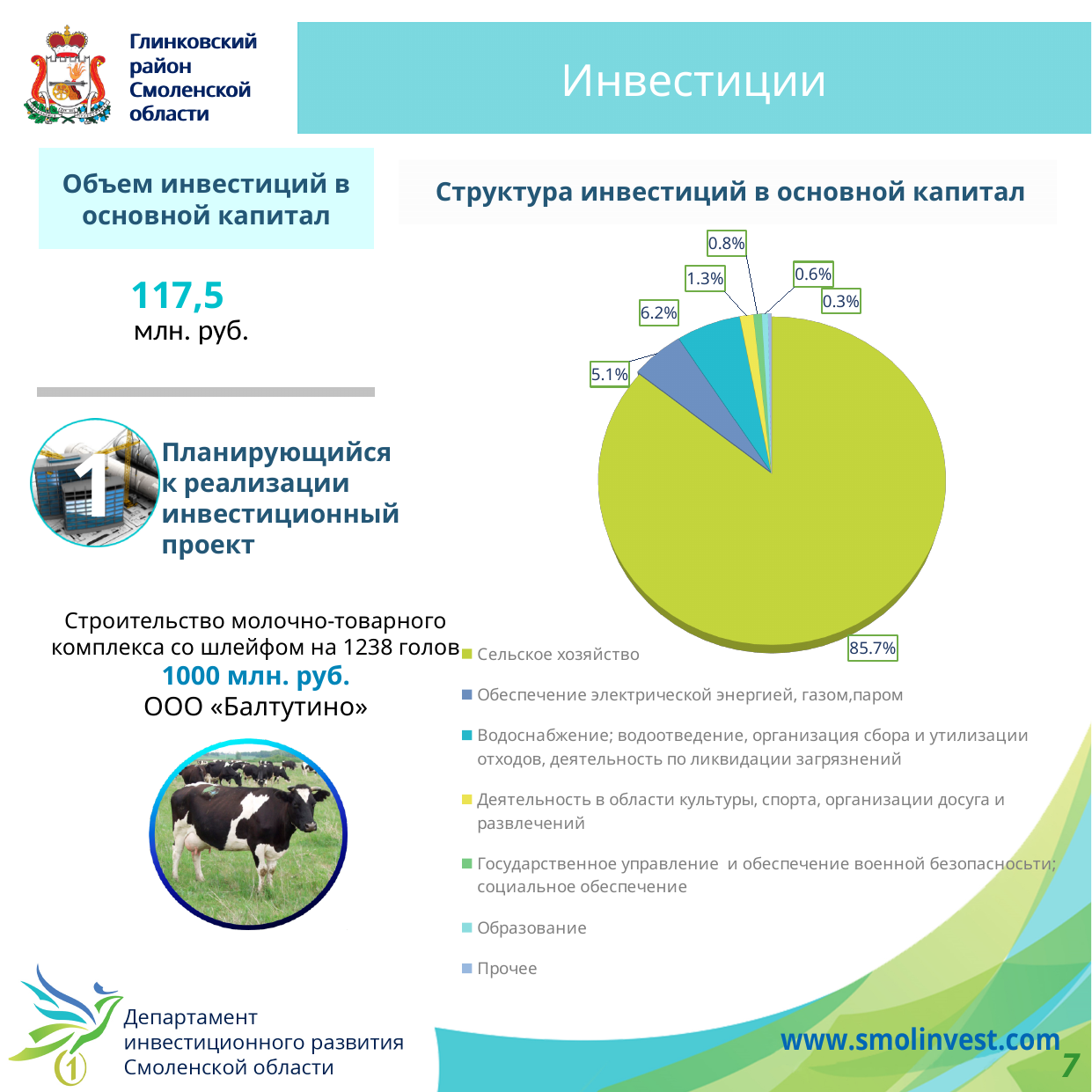
What share of the pie chart does «Образование» have? 0.6% Which category has the smallest slice of the pie chart? Прочее Which slice is larger: «Водоснабжение; водоотведение...» or «Обеспечение электрической энергией, газом,паром»? Водоснабжение; водоотведение, организация сбора и утилизации отходов, деятельность по ликвидации загрязнений How many categories does the legend of the pie chart list? 7 What share of the pie chart does «Водоснабжение; водоотведение, организация сбора и утилизации отходов, деятельность по ликвидации загрязнений» have? 6.2% What colour is the «Сельское хозяйство» slice in the pie chart? yellow-green What share of the pie chart does «Обеспечение электрической энергией, газом,паром» have? 5.1% What share of the pie chart does «Прочее» have? 0.3% What share of the pie chart does «Сельское хозяйство» have? 85.7% What kind of chart is shown under the title «Структура инвестиций в основной капитал»? pie chart Which category has the largest slice of the pie chart? Сельское хозяйство What is the difference in percentage points between the «Водоснабжение...» slice (6.2%) and the «Обеспечение электрической энергией, газом,паром» slice (5.1%)? 1.1